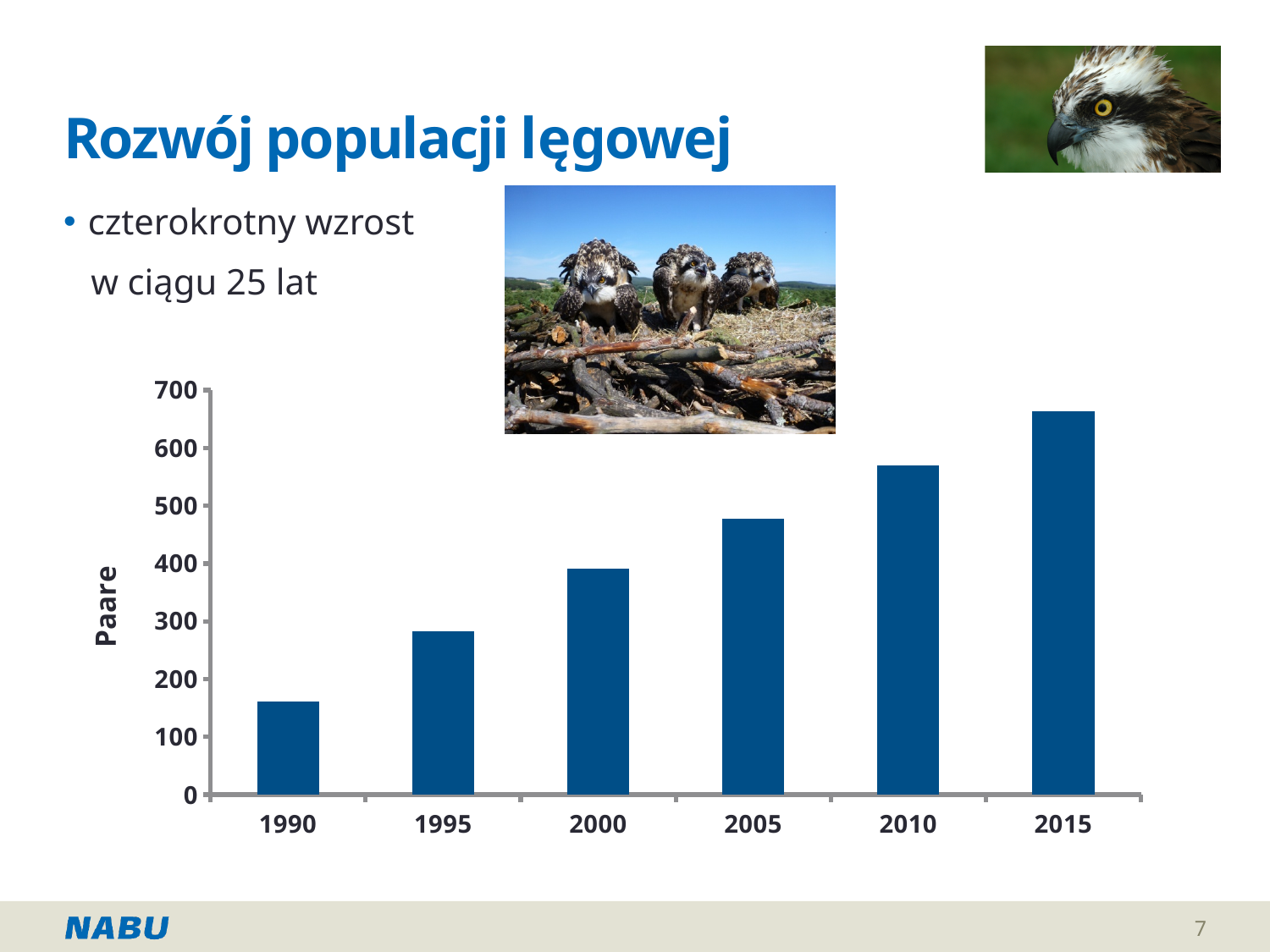
Is the value for 2010 greater or less than 500? greater What kind of chart is shown on the slide? bar chart Is the value for 2015 greater or less than 600? greater How many years are shown on the x axis of the chart? 6 Is the value for 1990 greater or less than 200? less Which is larger, the value for 2000 or the value for 2010? 2010 Do the values rise or fall from 1990 to 2015? rise What is the label on the y axis of the chart? Paare Which year has the highest value in the chart? 2015 Which year has the lowest value in the chart? 1990